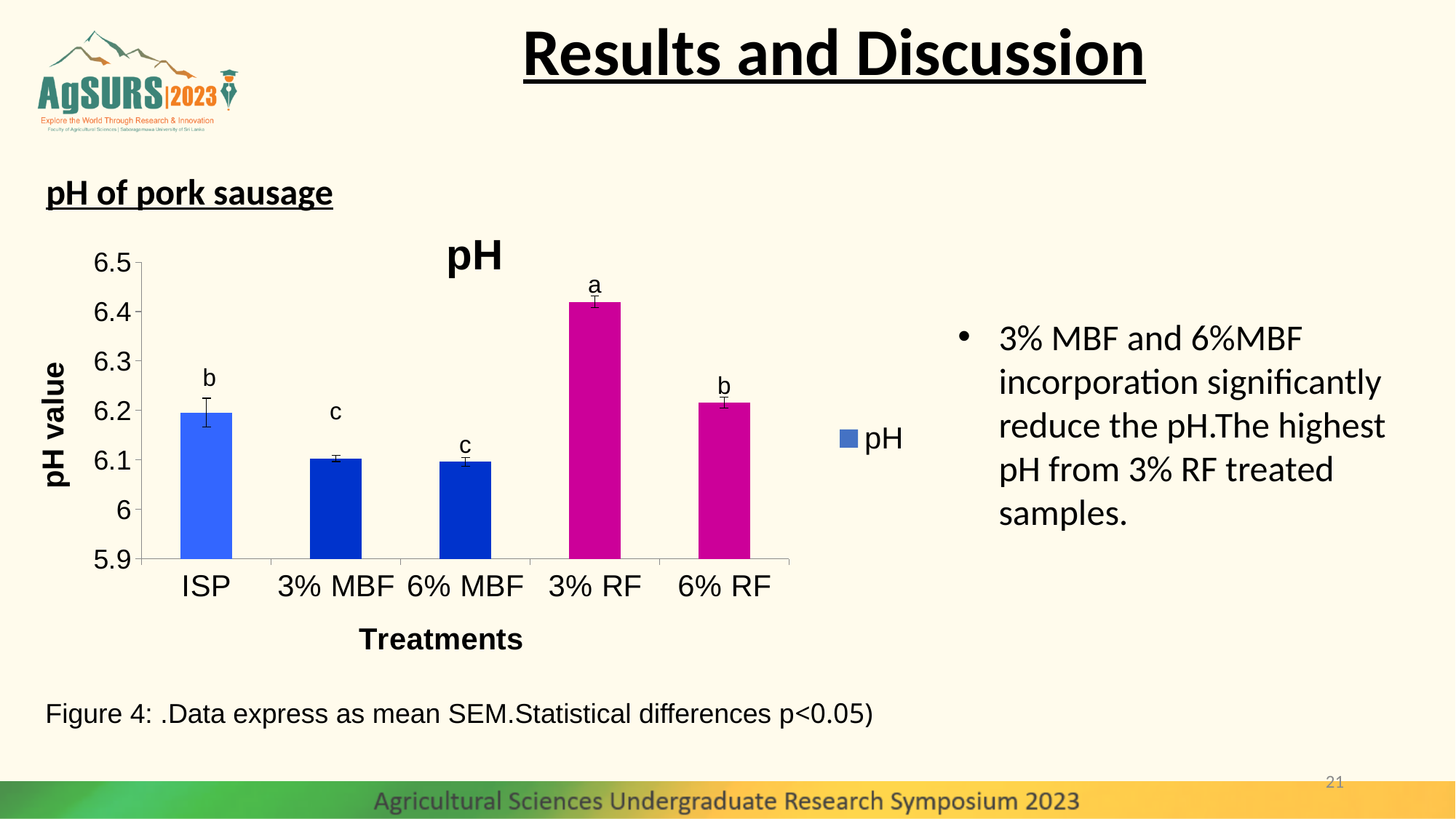
How many treatment categories are shown on the x axis of the chart? 5 Which has a higher pH value, ISP or 6% MBF? ISP How many series does the chart legend list? 1 Is the pH value for ISP greater or less than 6.3? less What is the x-axis title of the chart? Treatments Which has a higher pH value, ISP or 3% RF? 3% RF Is the pH value for 6% RF greater or less than 6.1? greater What kind of chart is shown on the slide? bar chart Is the pH value for 3% RF greater or less than 6.3? greater What is the title of the chart? pH Which has a higher pH value, 6% RF or 3% MBF? 6% RF Which treatment has the highest pH value in the chart? 3% RF